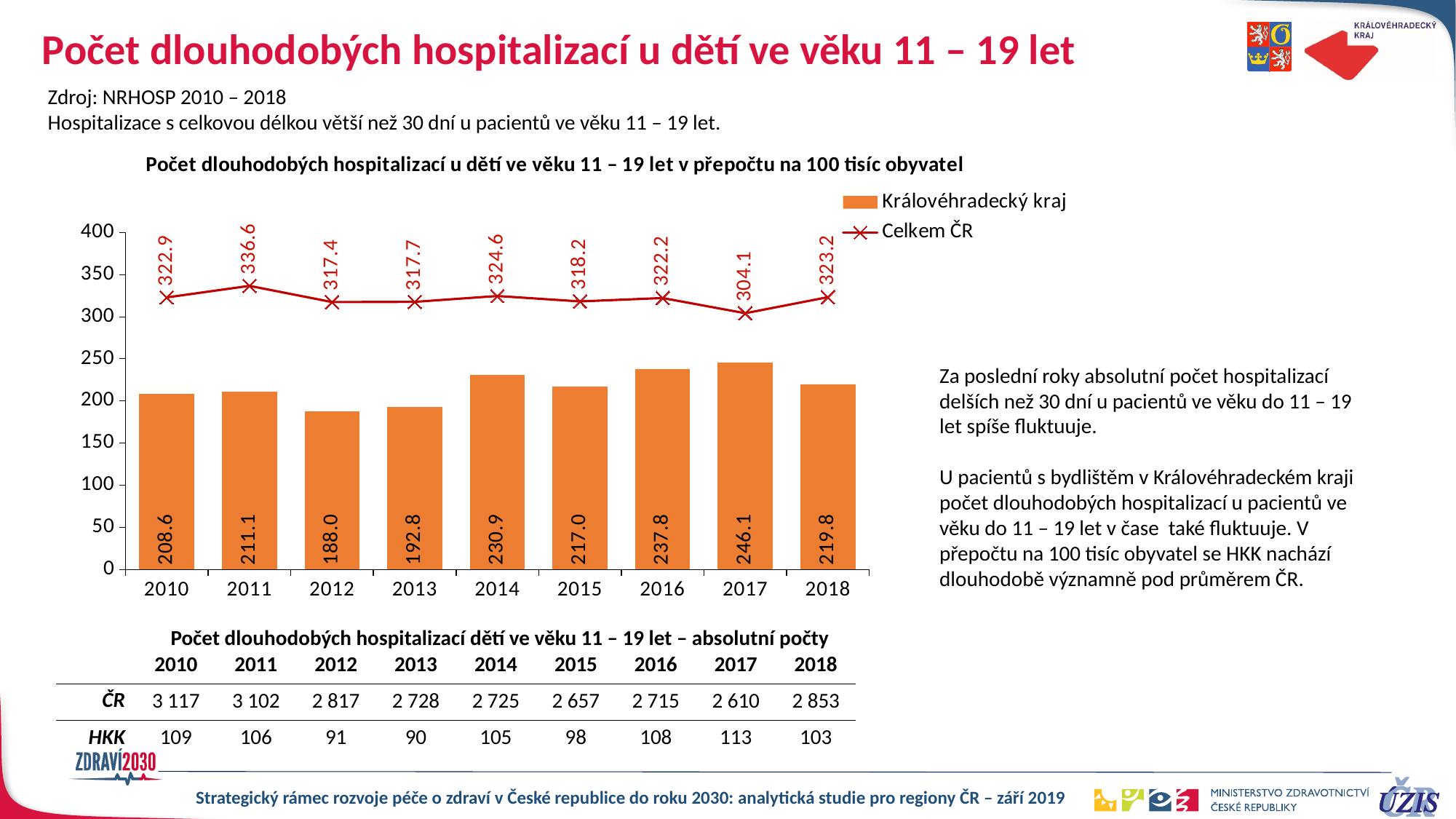
Is the value for Královéhradecký kraj in 2016 greater or less than 200? greater What is the value for Královéhradecký kraj in 2014? 230.9 In which year is the Královéhradecký kraj value lowest? 2012 In which year is the Královéhradecký kraj value highest? 2017 Which is larger in 2012: the Královéhradecký kraj value or the Celkem ČR value? Celkem ČR How many years are shown on the x axis of the chart? 9 In which year is the Celkem ČR value highest? 2011 What is the difference between the Celkem ČR value and the Královéhradecký kraj value in 2017? 58.0 What is the value for Celkem ČR in 2017? 304.1 How many series does the chart legend list? 2 What kind of chart is used to show the Královéhradecký kraj values? bar chart Which series is shown as a red line with cross markers? Celkem ČR